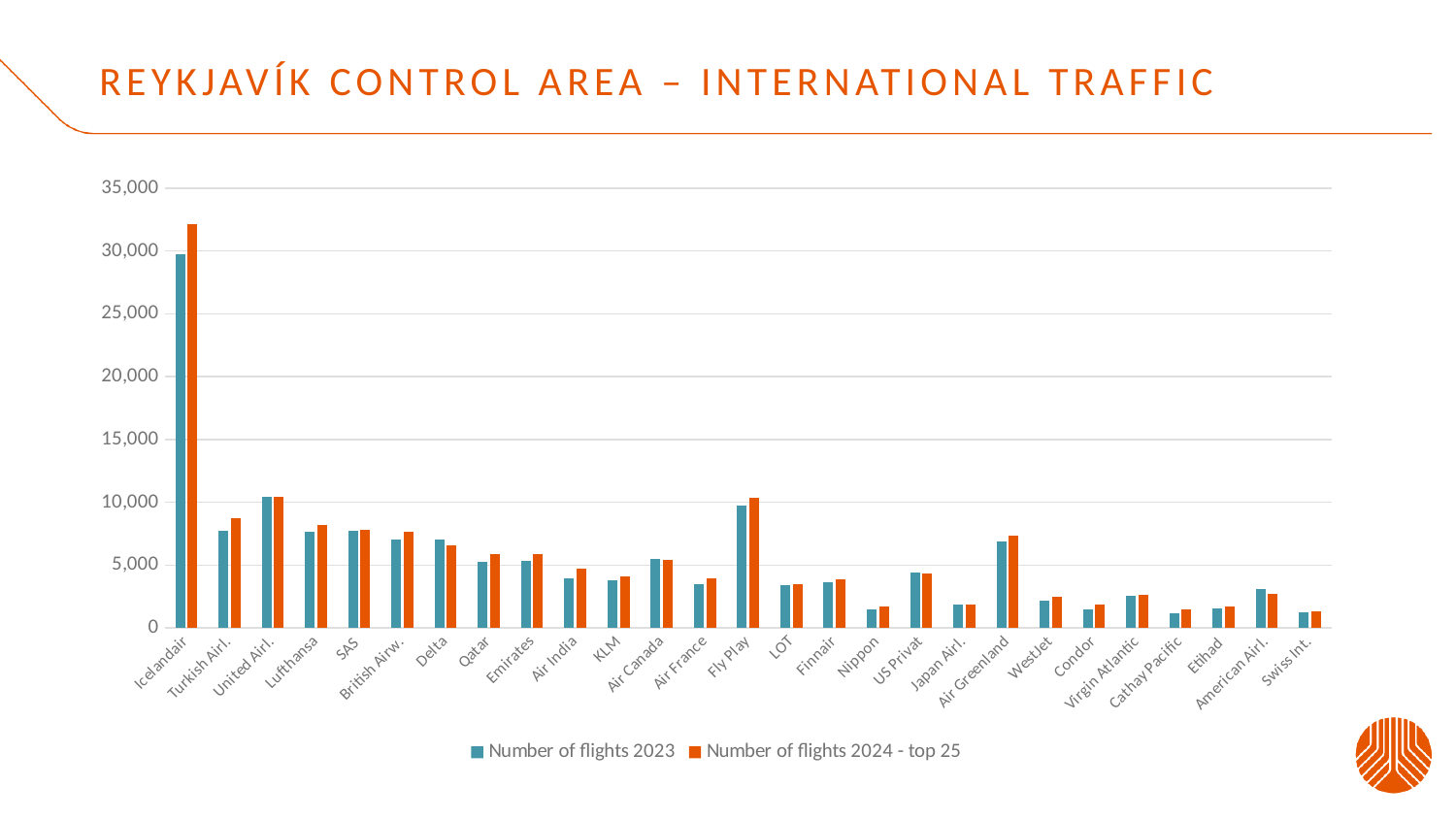
What kind of chart is shown on the slide? bar chart Is the number of flights in 2024 for Icelandair greater or less than 30,000? greater Is the number of flights in 2023 for Air Greenland greater or less than 5,000? greater Is the number of flights in 2023 for Air India greater or less than 5,000? less For Turkish Airl., which is larger: the number of flights in 2023 or in 2024? 2024 How many airlines are shown on the x axis? 27 For Delta, which is larger: the number of flights in 2023 or in 2024? 2023 How many series does the legend list? 2 Which airline has the highest number of flights in 2023? Icelandair What is the title of the slide? Reykjavík Control Area – International Traffic Which airline has the highest number of flights in 2024? Icelandair